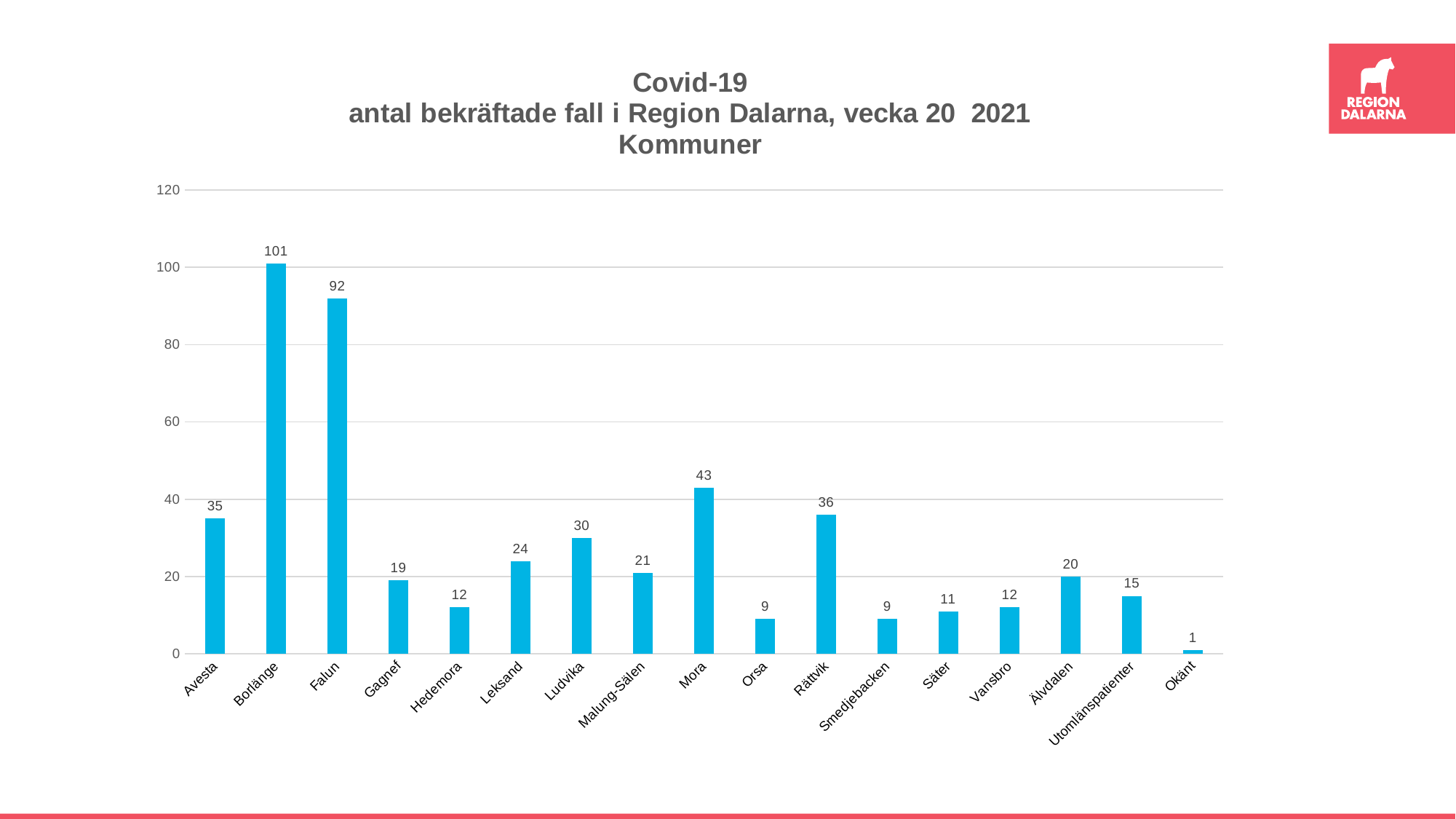
What is the number of confirmed cases for Borlänge? 101 What is the difference between the values for Borlänge and Falun? 9 How many categories are shown on the x axis? 17 What is the value shown for Utomlänspatienter? 15 What is the value shown for Mora? 43 Which has a higher value, Gagnef or Älvdalen? Älvdalen Which has a higher value, Avesta or Ludvika? Avesta What is the title of the chart? Covid-19 antal bekräftade fall i Region Dalarna, vecka 20 2021 Kommuner What kind of chart is shown on the slide? Bar chart Which municipality has the highest number of confirmed cases? Borlänge What is the difference between the values for Mora and Rättvik? 7 Which category has the lowest value in the chart? Okänt